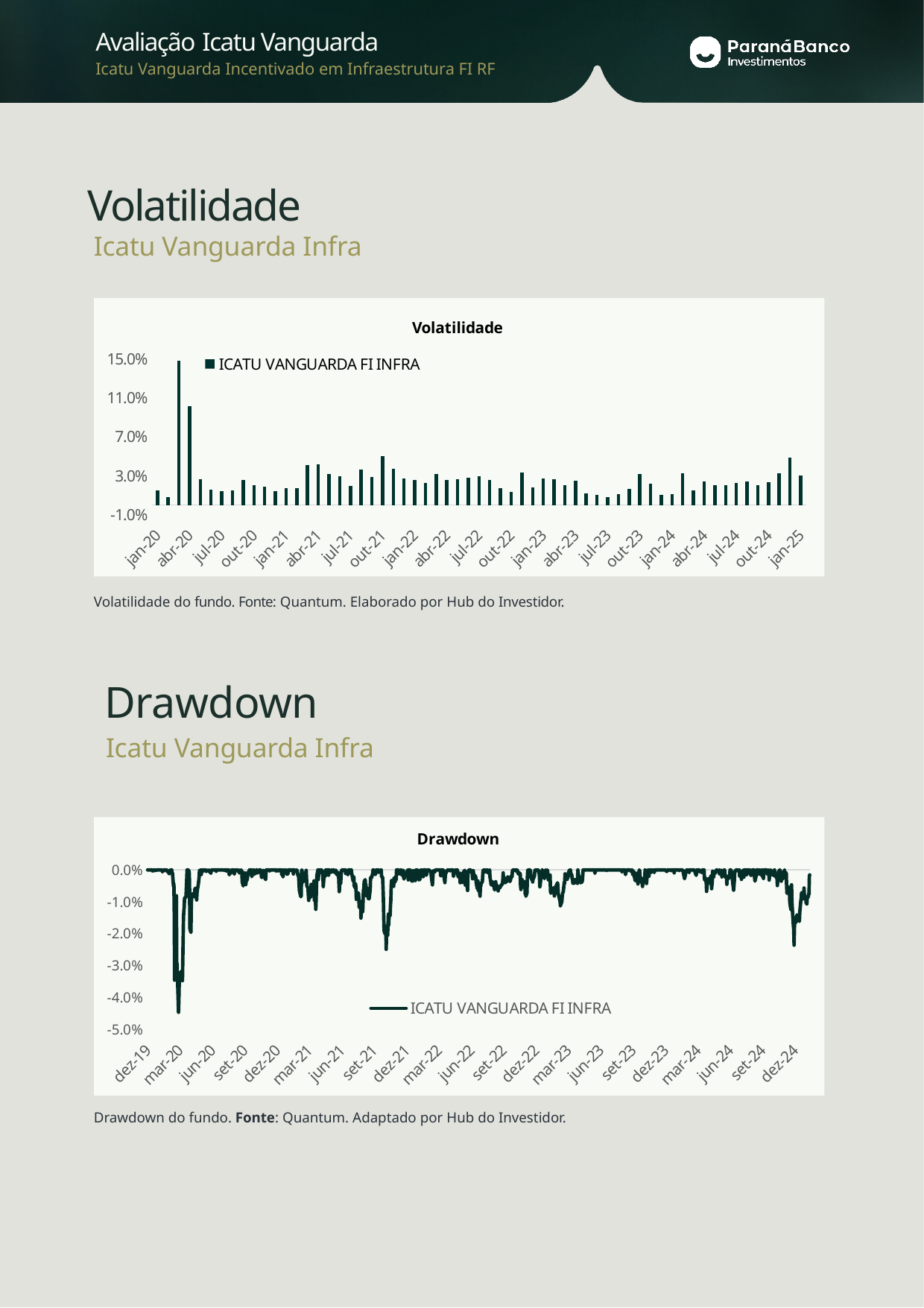
In the Drawdown chart, is the lowest point near dez-24 greater or less than -3.0%? greater In the Volatilidade chart, is the bar at jan-20 greater or less than 3.0%? less What kind of chart is the Volatilidade chart? bar chart In the Volatilidade chart, is the tallest bar greater or less than 11.0%? greater How many series does the legend of the Drawdown chart list? 1 How many series does the legend of the Volatilidade chart list? 1 In the Drawdown chart, around which x-axis label does the deepest drawdown occur? mar-20 What kind of chart is the Drawdown chart? line chart What is the name of the series shown in the Volatilidade chart's legend? ICATU VANGUARDA FI INFRA What is the title printed at the top of the lower chart? Drawdown